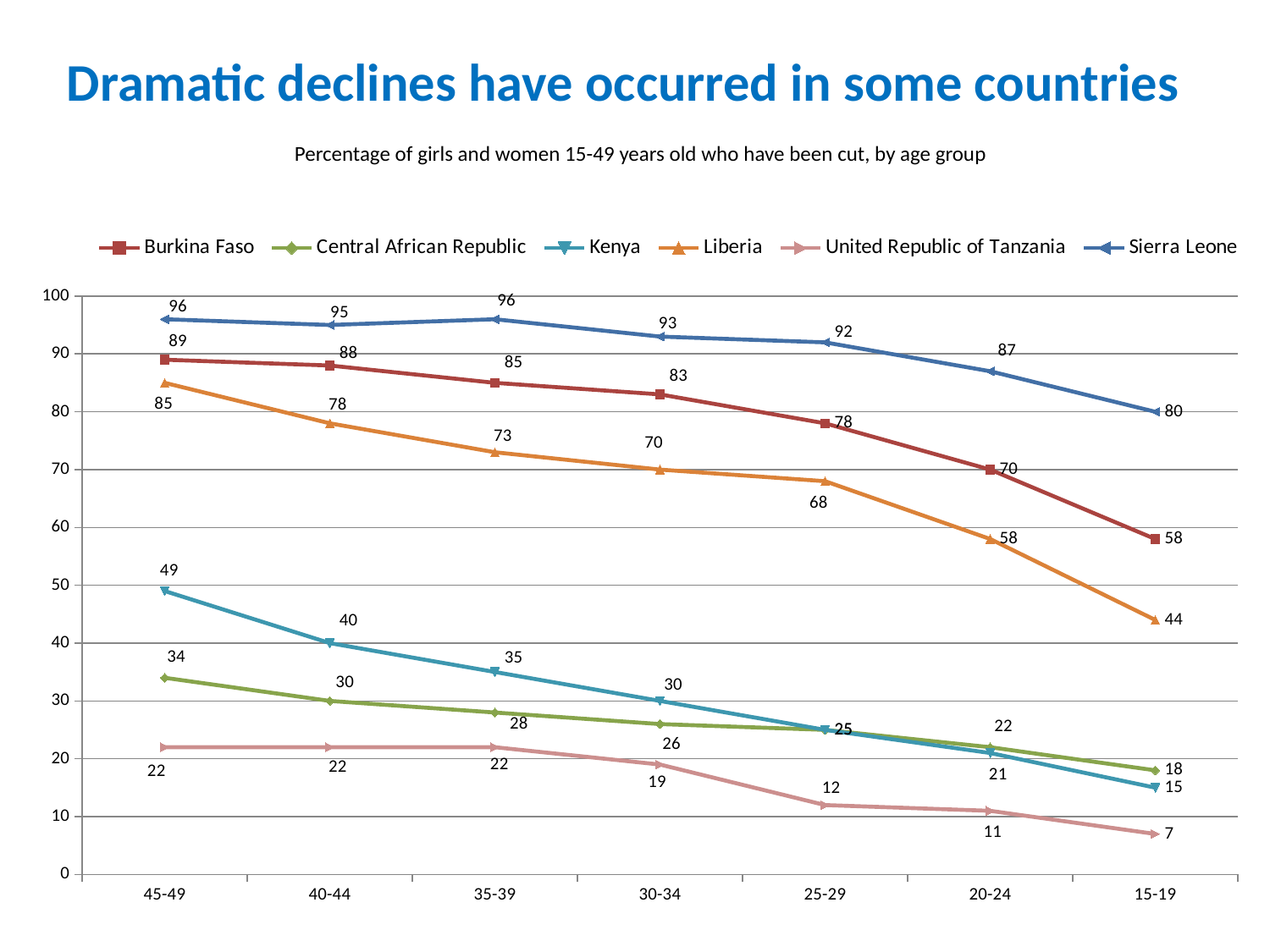
In the 40-44 age group, which is larger: the value for Kenya or for Central African Republic? Kenya What is the difference between the Sierra Leone and Burkina Faso values in the 20-24 age group? 17 How many age groups are shown on the x axis? 7 By how much does the Burkina Faso value fall from the 45-49 age group to the 15-19 age group? 31 Which country has the lowest value in the 15-19 age group? United Republic of Tanzania What kind of chart is shown on the slide? Line chart Which country has the highest value in the 45-49 age group? Sierra Leone How many countries does the legend list? 6 What is the value for United Republic of Tanzania in the 25-29 age group? 12 What is the value for Liberia in the 45-49 age group? 85 What is the value for Sierra Leone in the 15-19 age group? 80 Do the values for Liberia rise or fall from the 45-49 age group to the 15-19 age group? Fall